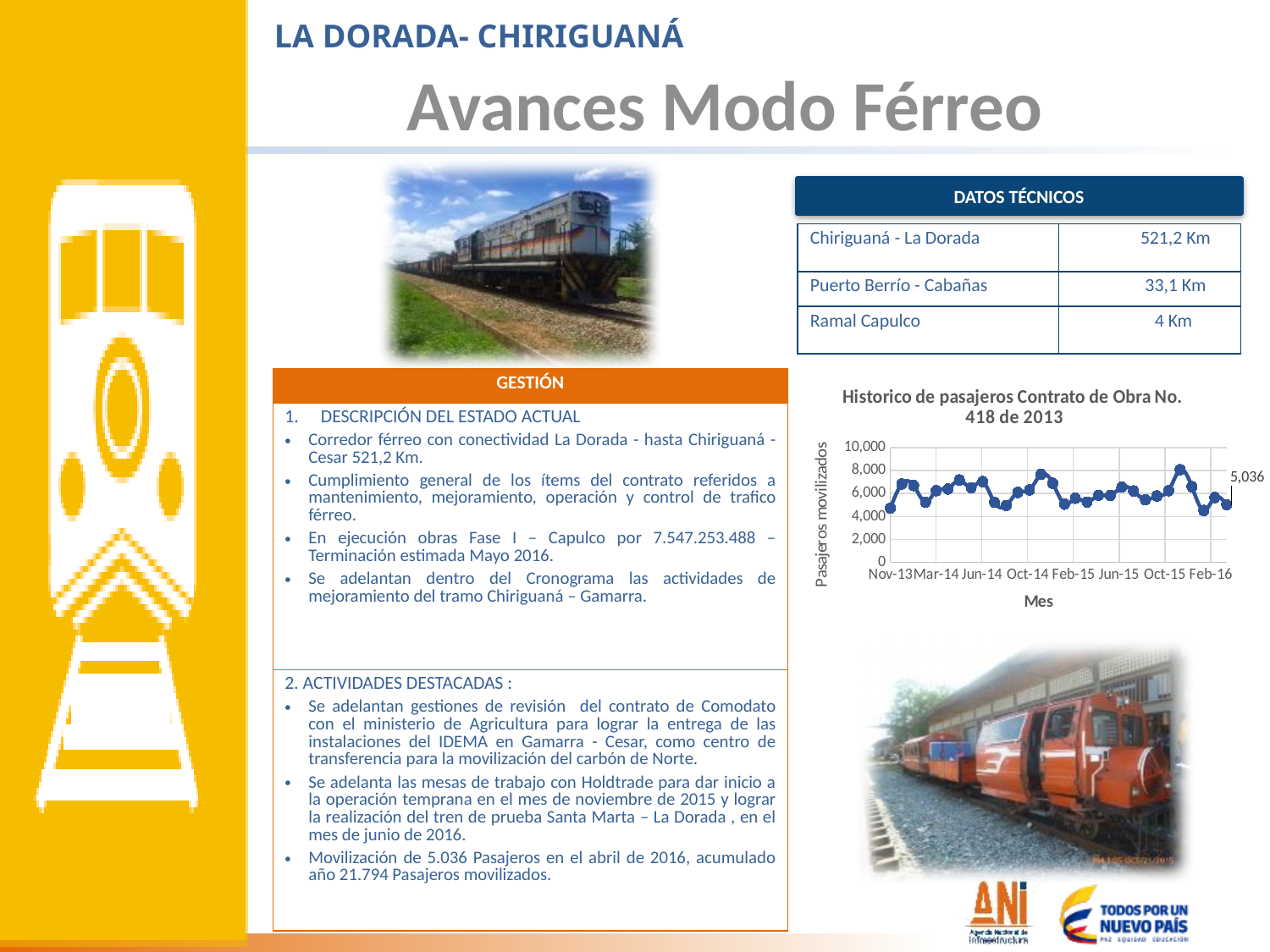
On the 'Historico de pasajeros' chart, is the highest point of the line greater or less than 10,000? less On the 'Historico de pasajeros' chart, is the final labelled value greater or less than 6,000? less How many month labels are shown on the x axis of the 'Historico de pasajeros' chart? 8 On the 'Historico de pasajeros' chart, is the highest point of the line greater or less than 6,000? greater What is the label of the x axis on the 'Historico de pasajeros' chart? Mes What is the value of the last data point labelled on the 'Historico de pasajeros' chart? 5,036 What kind of chart is 'Historico de pasajeros Contrato de Obra No. 418 de 2013'? line chart What is the label of the y axis on the 'Historico de pasajeros' chart? Pasajeros movilizados